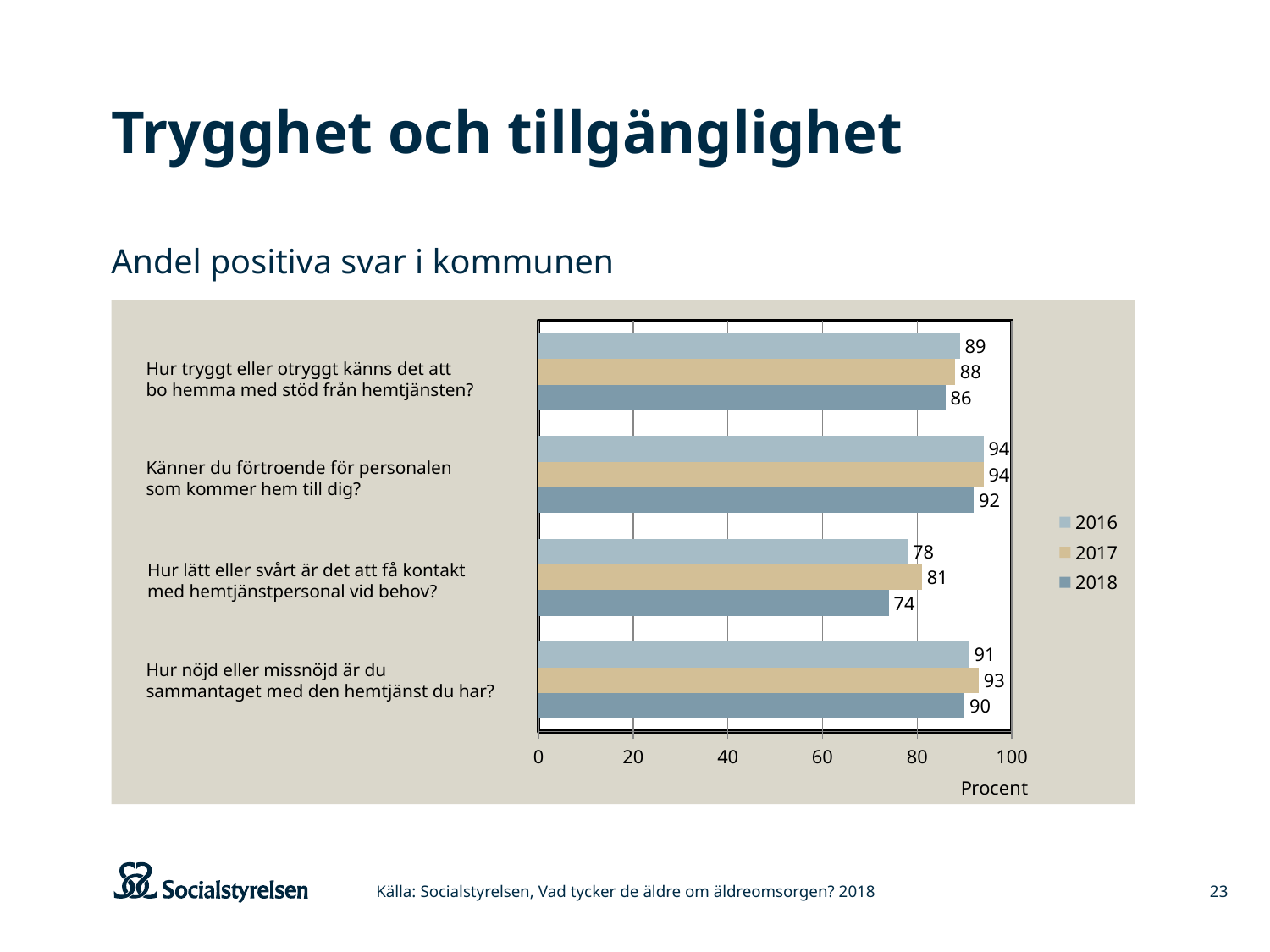
Which question has the lowest 2018 value? Hur lätt eller svårt är det att få kontakt med hemtjänstpersonal vid behov? Which question has the highest 2016 value? Känner du förtroende för personalen som kommer hem till dig? What is the 2016 value for "Hur nöjd eller missnöjd är du sammantaget med den hemtjänst du har?"? 91 How many question categories are shown on the chart? 4 How many series does the legend list? 3 What type of chart is shown on the slide? bar chart For "Hur nöjd eller missnöjd är du sammantaget med den hemtjänst du har?", which year has the larger value, 2017 or 2018? 2017 What is the difference between the 2017 and 2018 values for "Hur lätt eller svårt är det att få kontakt med hemtjänstpersonal vid behov?"? 7 Is the 2016 value for "Hur lätt eller svårt är det att få kontakt med hemtjänstpersonal vid behov?" greater or less than 80? less What is the 2017 value for "Hur lätt eller svårt är det att få kontakt med hemtjänstpersonal vid behov?"? 81 What is the 2018 value for "Hur tryggt eller otryggt känns det att bo hemma med stöd från hemtjänsten?"? 86 What is the label on the horizontal axis of the chart? Procent